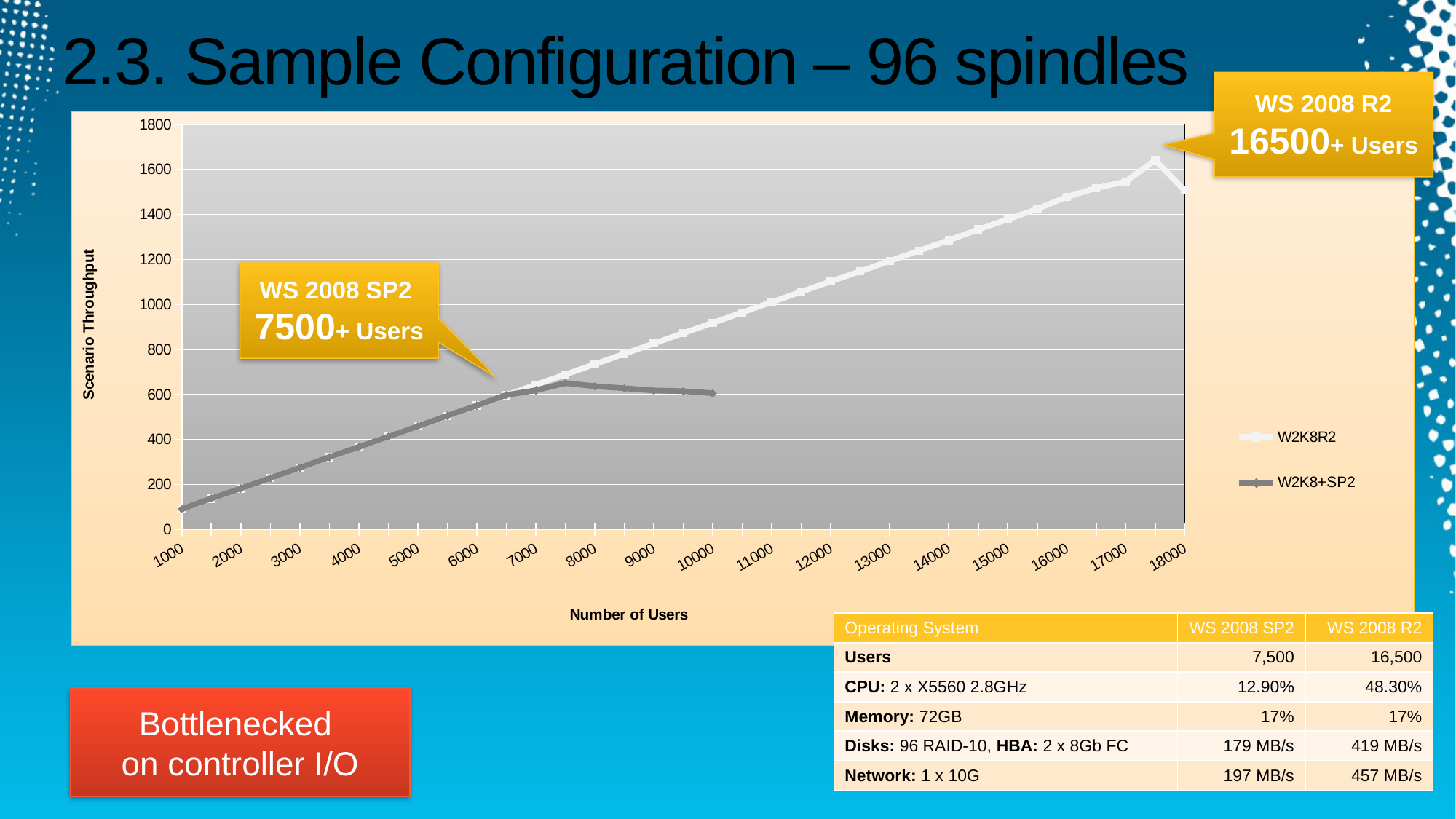
Which series reaches the highest Scenario Throughput on the chart? W2K8R2 At 10000 users, which series has the higher Scenario Throughput, W2K8R2 or W2K8+SP2? W2K8R2 Is the W2K8+SP2 value at 4000 users greater or less than 200? greater Is the W2K8R2 value at 14000 users greater or less than 1200? greater How many labelled tick values are shown on the x axis? 18 Is the W2K8+SP2 value at 10000 users greater or less than 800? less What kind of chart is shown on the slide? Line chart Does the W2K8R2 series rise or fall as the number of users increases from 1000 to 17000? Rise How many series does the chart legend list? 2 What is the title of the chart's x axis? Number of Users What are the two series named in the chart legend? W2K8R2 and W2K8+SP2